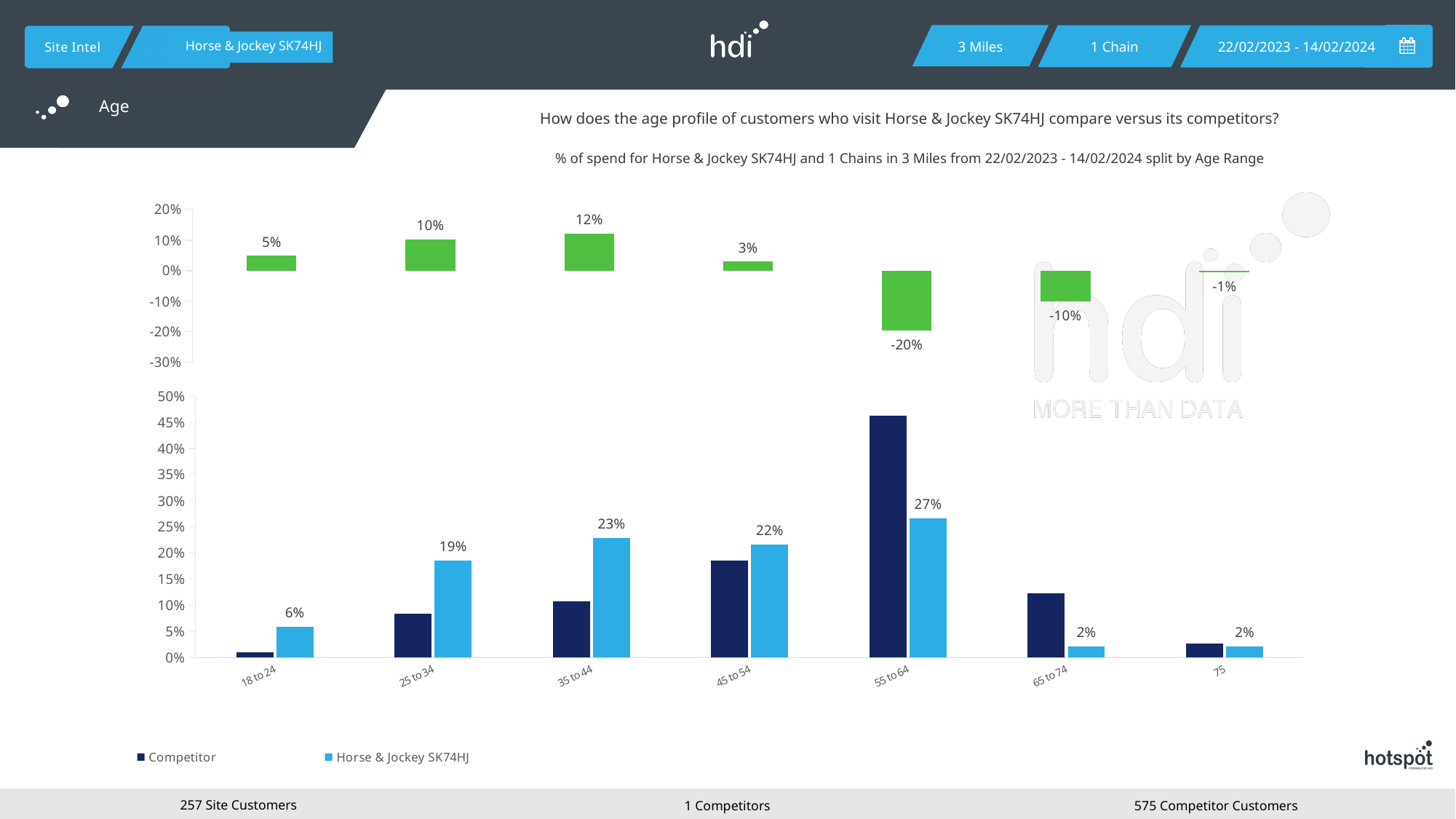
In the bottom chart, is the Competitor value for 25 to 34 greater or less than 10%? less In the bottom chart, what is the difference between the Horse & Jockey SK74HJ values for 25 to 34 and 18 to 24? 13% In the bottom chart, what is the value for Horse & Jockey SK74HJ in the 35 to 44 age range? 23% In the bottom chart, which is larger for the 55 to 64 age range: Competitor or Horse & Jockey SK74HJ? Competitor How many series does the legend of the bottom chart list? 2 What kind of chart is the bottom chart? bar chart In the bottom chart, is the Competitor value for 55 to 64 greater or less than 40%? greater In the top chart, which age range has the lowest value? 55 to 64 In the bottom chart, what is the value for Horse & Jockey SK74HJ in the 55 to 64 age range? 27% In the top chart, what is the value shown for the 35 to 44 age range? 12% In the bottom chart, which age range has the highest value for Horse & Jockey SK74HJ? 55 to 64 In the top chart, what is the value shown for the 55 to 64 age range? -20%